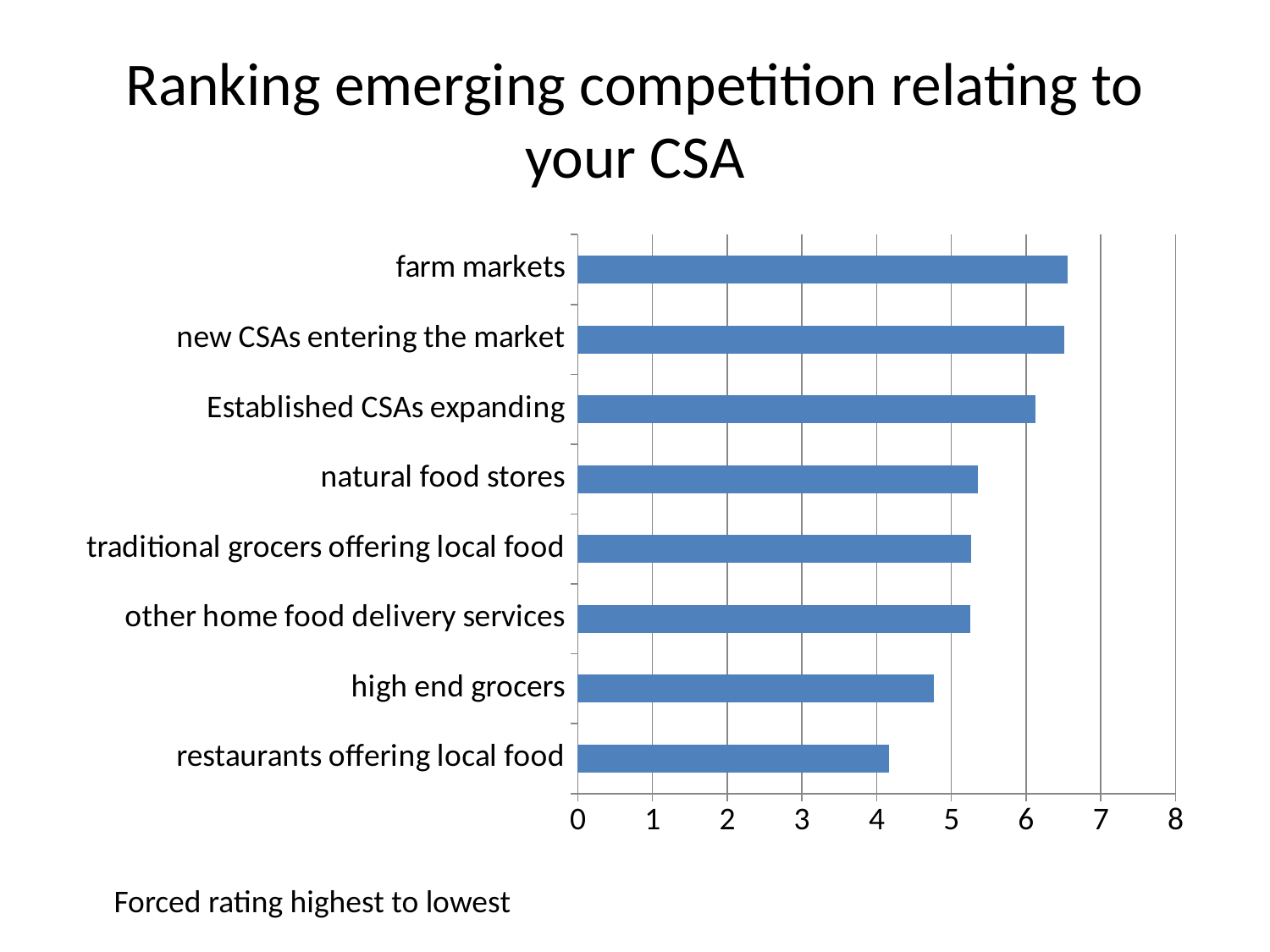
Is the value for restaurants offering local food greater or less than 5? less Is the value for farm markets greater or less than 6? greater How many categories are plotted in the chart? 8 Is the value for Established CSAs expanding greater or less than 6? greater What is the title of the chart on the slide? Ranking emerging competition relating to your CSA Which has a larger value: Established CSAs expanding or natural food stores? Established CSAs expanding What kind of chart is shown on the slide? bar chart Which has a larger value: high end grocers or restaurants offering local food? high end grocers Which category has the lowest value in the chart? restaurants offering local food